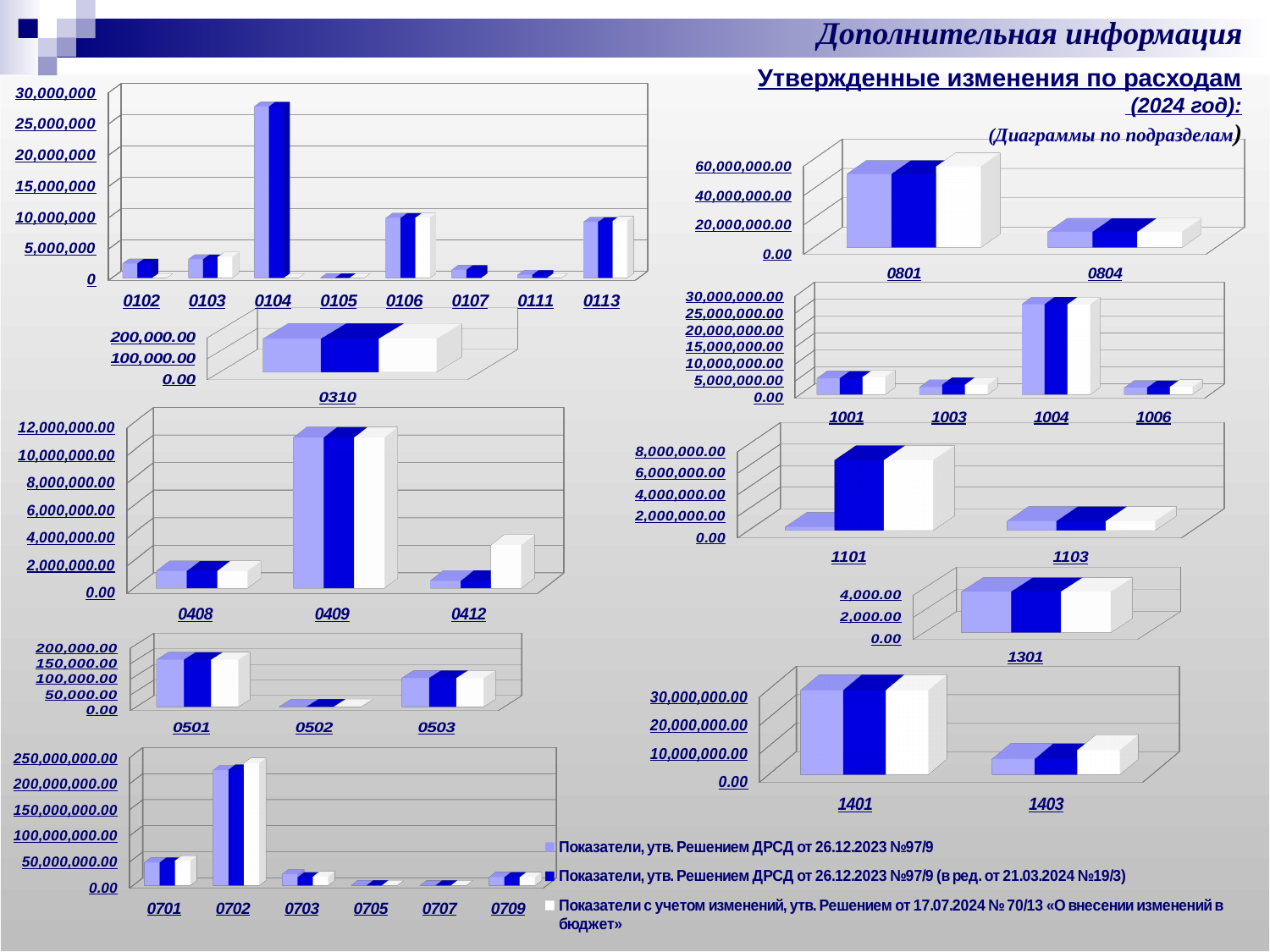
How many categories are shown in the chart with categories 0701 through 0709 (bottom left)? 6 In the chart with categories 0102 through 0113 (top left), which category has the highest value? 0104 How many series does the legend at the bottom of the slide list? 3 In the chart with categories 0801 and 0804, is the value for 0804 greater or less than 40,000,000.00? less How many categories are shown in the chart with categories 0102 through 0113 (top left)? 8 In the chart with categories 0408, 0409 and 0412, is the value for 0409 greater or less than 10,000,000.00? greater In the chart with categories 0701 through 0709 (bottom left), which category has the highest value? 0702 In the chart with categories 1001, 1003, 1004 and 1006, which category has the highest value? 1004 In the chart with categories 1401 and 1403, which category has the larger value? 1401 In the chart with categories 0102 through 0113 (top left), is the value for 0104 greater or less than 25,000,000? greater In the chart with categories 0801 and 0804, which category has the larger value? 0801